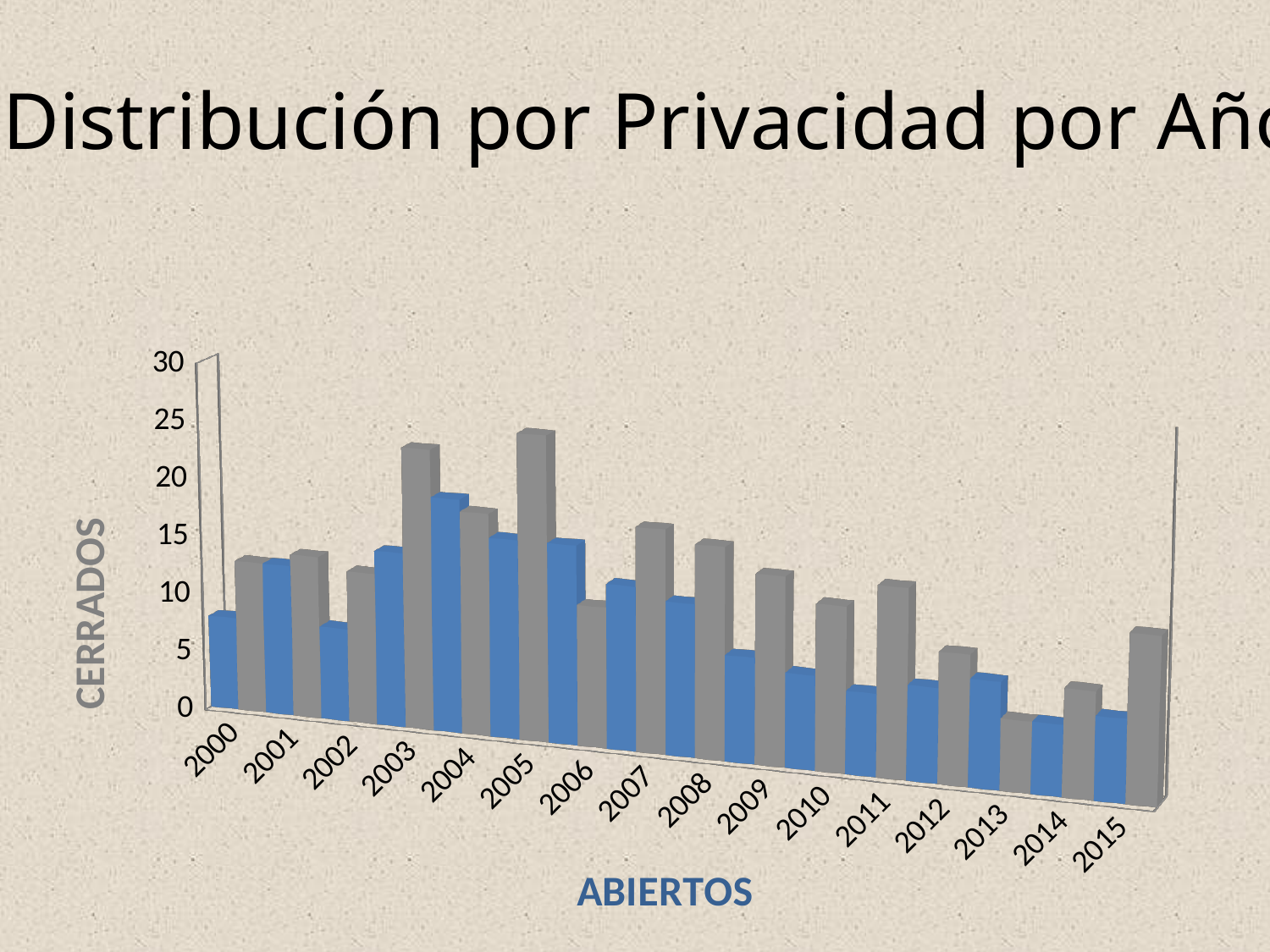
What label appears on the vertical axis of the chart? CERRADOS Do the blue bars generally rise or fall from 2005 to 2014? fall How many years are shown along the x axis of the chart? 16 For 2008, which bar is taller, the blue one or the gray one? gray Is the blue bar for 2000 greater or less than 10? less Which year has the tallest blue bar? 2004 Is the blue bar for 2010 greater or less than 5? less What kind of chart is shown on the slide? bar chart Which is taller, the blue bar for 2003 or the blue bar for 2010? 2003 Is the gray bar for 2005 greater or less than 20? greater What is the title of the chart slide? Distribución por Privacidad por Año